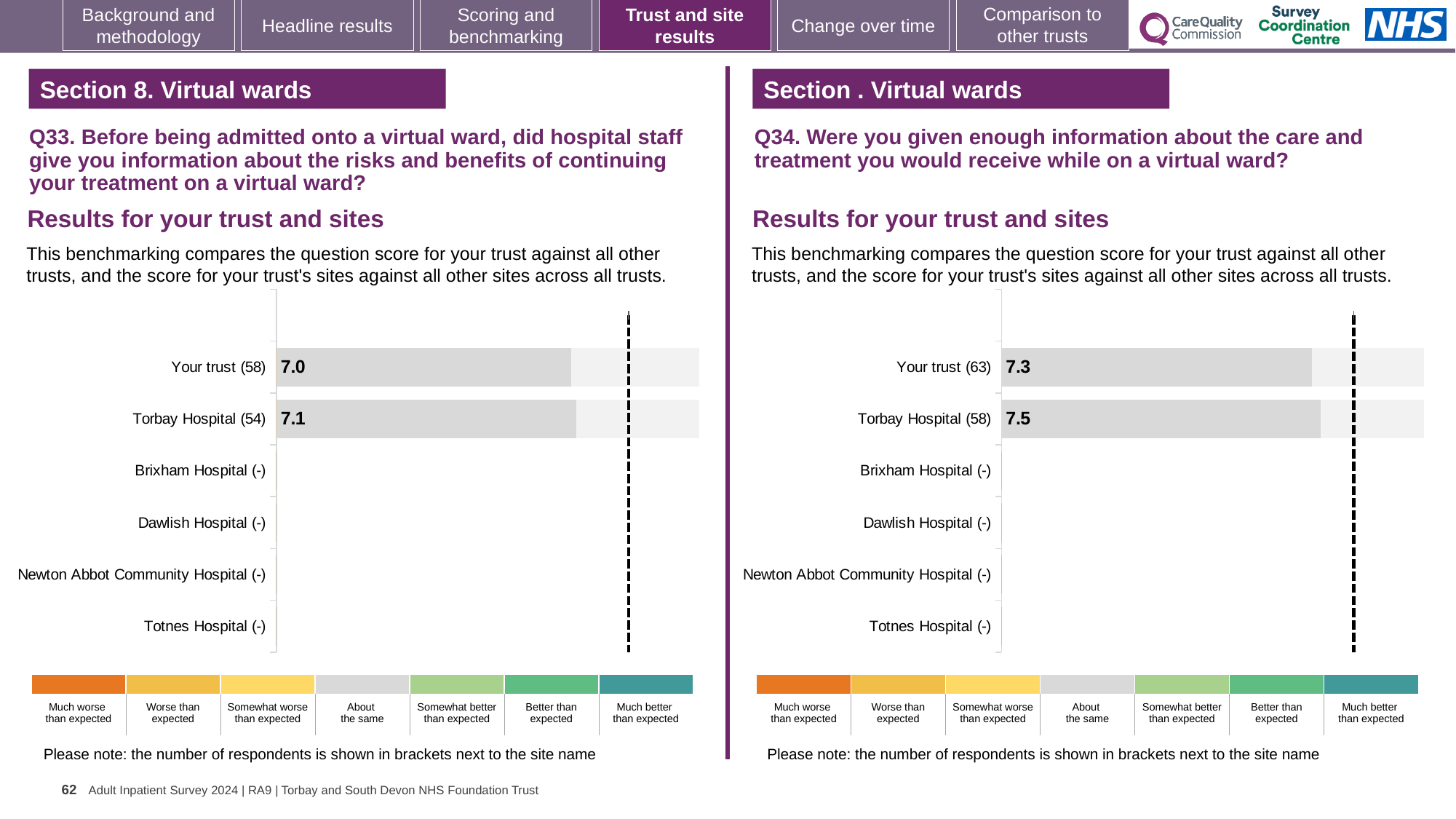
In the Q34 chart on the right, what is the score for Your trust? 7.3 In the Q33 chart on the left, how many respondents are shown in brackets for Your trust? 58 In the Q33 chart on the left, what is the score for Your trust? 7.0 In the Q34 chart on the right, what is the difference between the Torbay Hospital score and the Your trust score? 0.2 In the Q34 chart on the right, what is the score for Torbay Hospital? 7.5 In the Q34 chart on the right, which is larger, the score for Your trust or for Torbay Hospital? Torbay Hospital In the Q33 chart on the left, how many categories have a plotted bar with a score? 2 How many site/trust categories are listed on the y axis of the Q33 chart on the left? 6 In the Q33 chart on the left, what is the score for Torbay Hospital? 7.1 In the Q34 chart on the right, how many respondents are shown in brackets for Torbay Hospital? 58 In the Q33 chart on the left, what is the difference between the Torbay Hospital score and the Your trust score? 0.1 What kind of chart is used for the Q34 results on the right? Bar chart